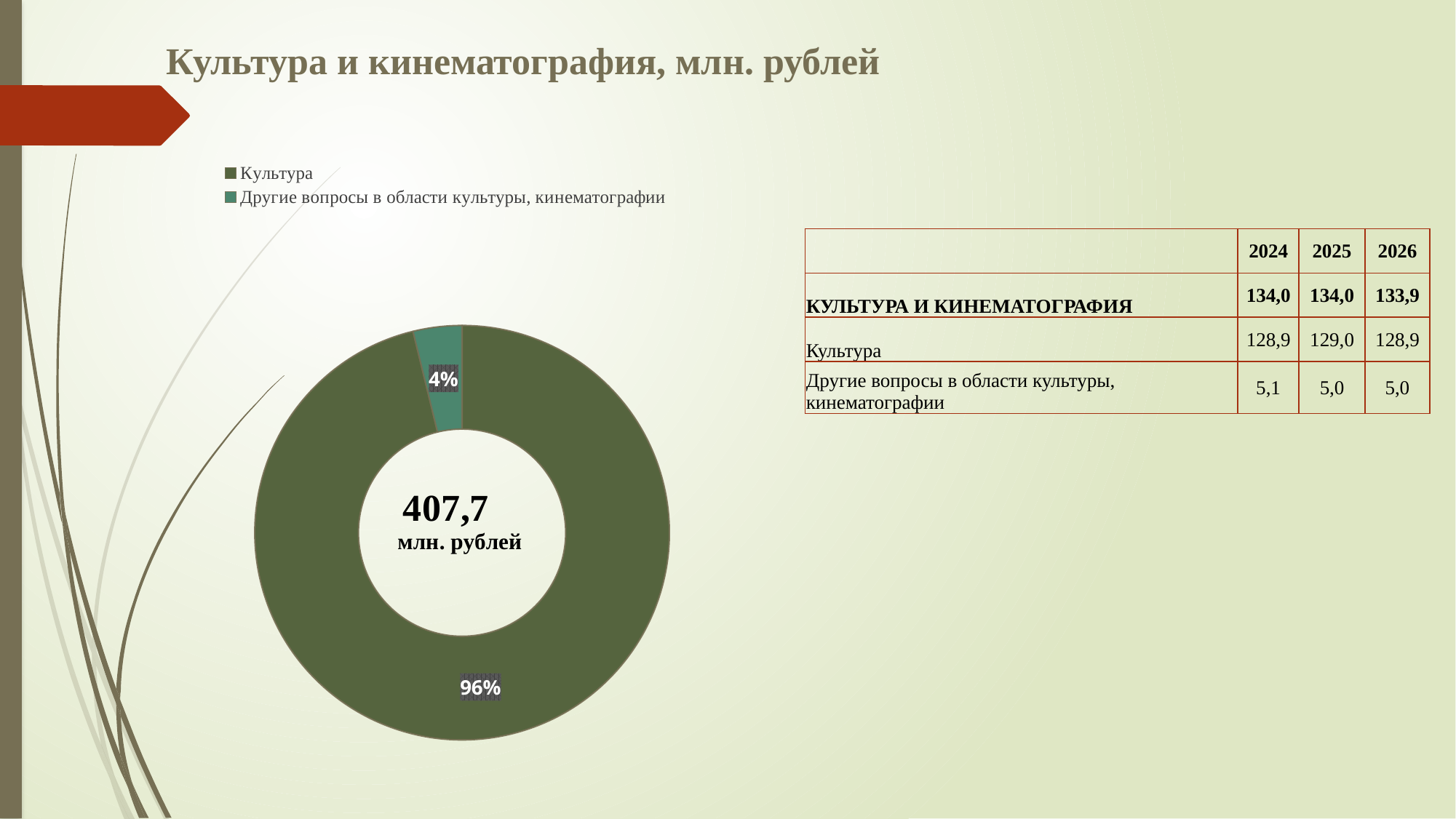
What is the title of the slide containing the chart? Культура и кинематография, млн. рублей Which slice of the pie chart is the largest? Культура How many slices does the pie chart have? 2 Which slice of the pie chart is the smallest? Другие вопросы в области культуры, кинематографии What share of the pie chart does the slice "Другие вопросы в области культуры, кинематографии" represent? 4% What share of the pie chart does the slice "Культура" represent? 96% What kind of chart is shown on the slide? Pie (donut) chart How many entries does the chart legend list? 2 Which is larger in the pie chart: the share for "Культура" or the share for "Другие вопросы в области культуры, кинематографии"? Культура Which legend entry is shown in the dark green colour? Культура What total value is printed in the centre of the donut chart? 407,7 млн. рублей What is the difference in percentage points between the "Культура" slice and the "Другие вопросы в области культуры, кинематографии" slice? 92 percentage points